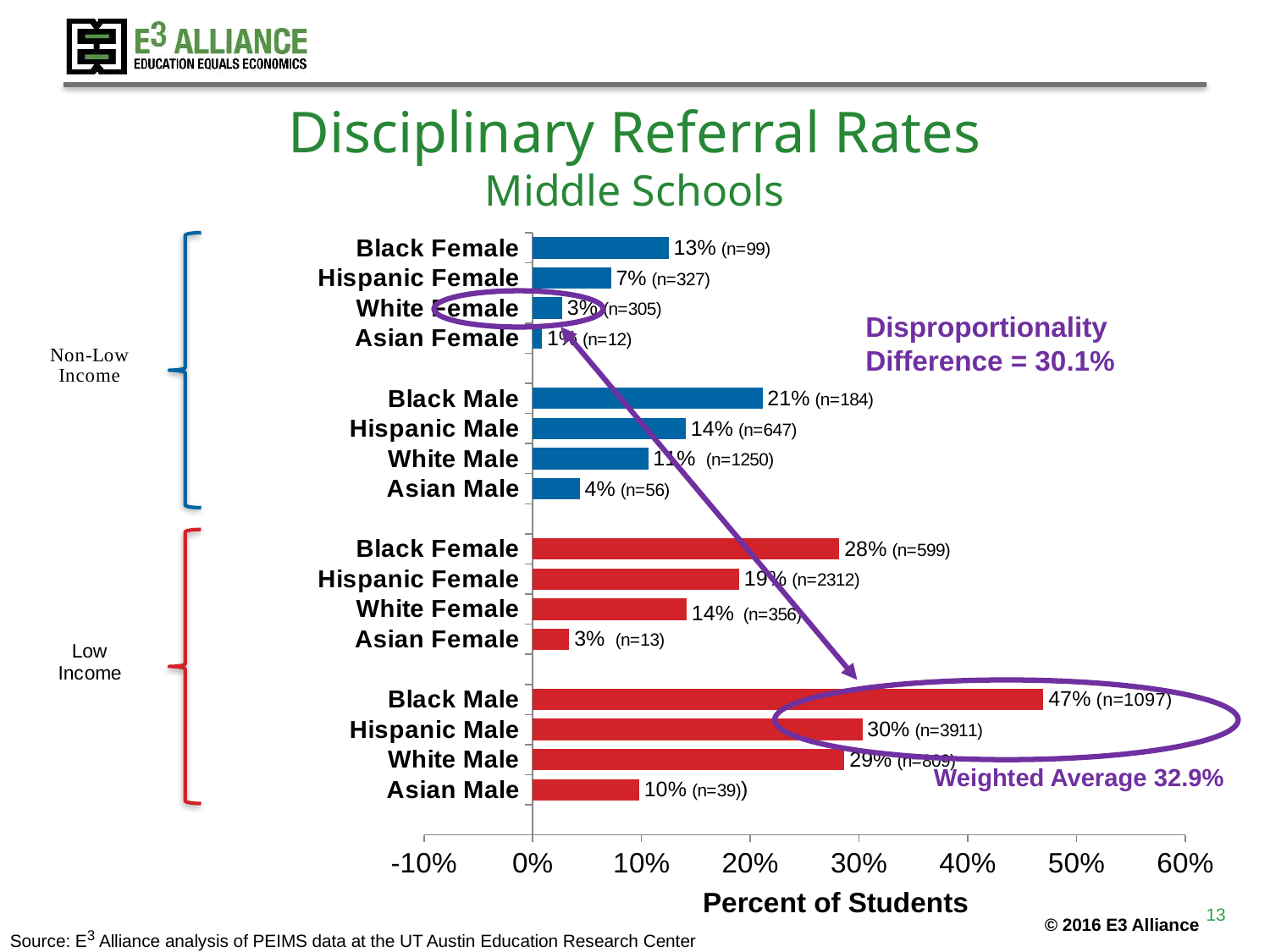
What kind of chart is shown on the slide? Bar chart Which has a higher referral rate: Non-Low Income Hispanic Male or Non-Low Income Hispanic Female students? Non-Low Income Hispanic Male Which group has the highest disciplinary referral rate on the chart? Low Income Black Male What is the difference in referral rate between Low Income Black Male students and Non-Low Income Black Male students? 26 percentage points Which group has the lowest disciplinary referral rate on the chart? Non-Low Income Asian Female What is the title of the x axis? Percent of Students What is the sample size (n) shown for Low Income Hispanic Male students? n=3911 How many bars are plotted on the chart? 16 What is the disciplinary referral rate for Low Income Asian Male students? 10% Is the referral rate for Low Income Black Male students greater or less than 40%? greater What is the disciplinary referral rate for Non-Low Income Black Female students? 13% What is the disciplinary referral rate for Low Income Black Male students? 47%